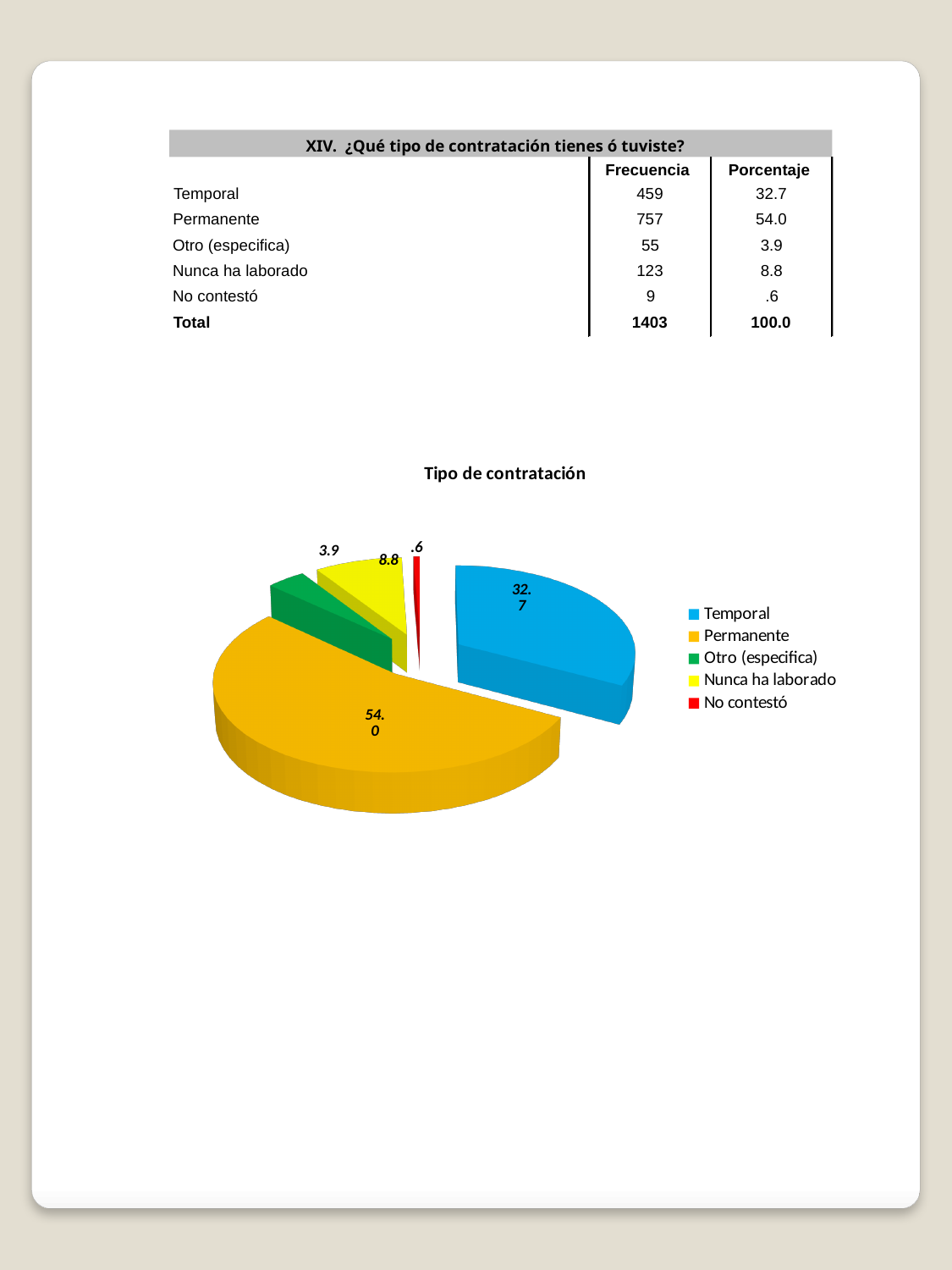
What value is shown for the Otro (especifica) slice? 3.9 What value is shown for the Nunca ha laborado slice? 8.8 How many slices does the pie chart have? 5 What value is shown for the Permanente slice? 54.0 What is the title of the chart? Tipo de contratación Which colour represents Nunca ha laborado in the legend? yellow Which category has the smallest slice? No contestó What is the difference between the Permanente and Temporal values? 21.3 Which category has the largest slice? Permanente What value is shown for the Temporal slice? 32.7 What type of chart is shown on the slide? pie chart What value is shown for the No contestó slice? .6